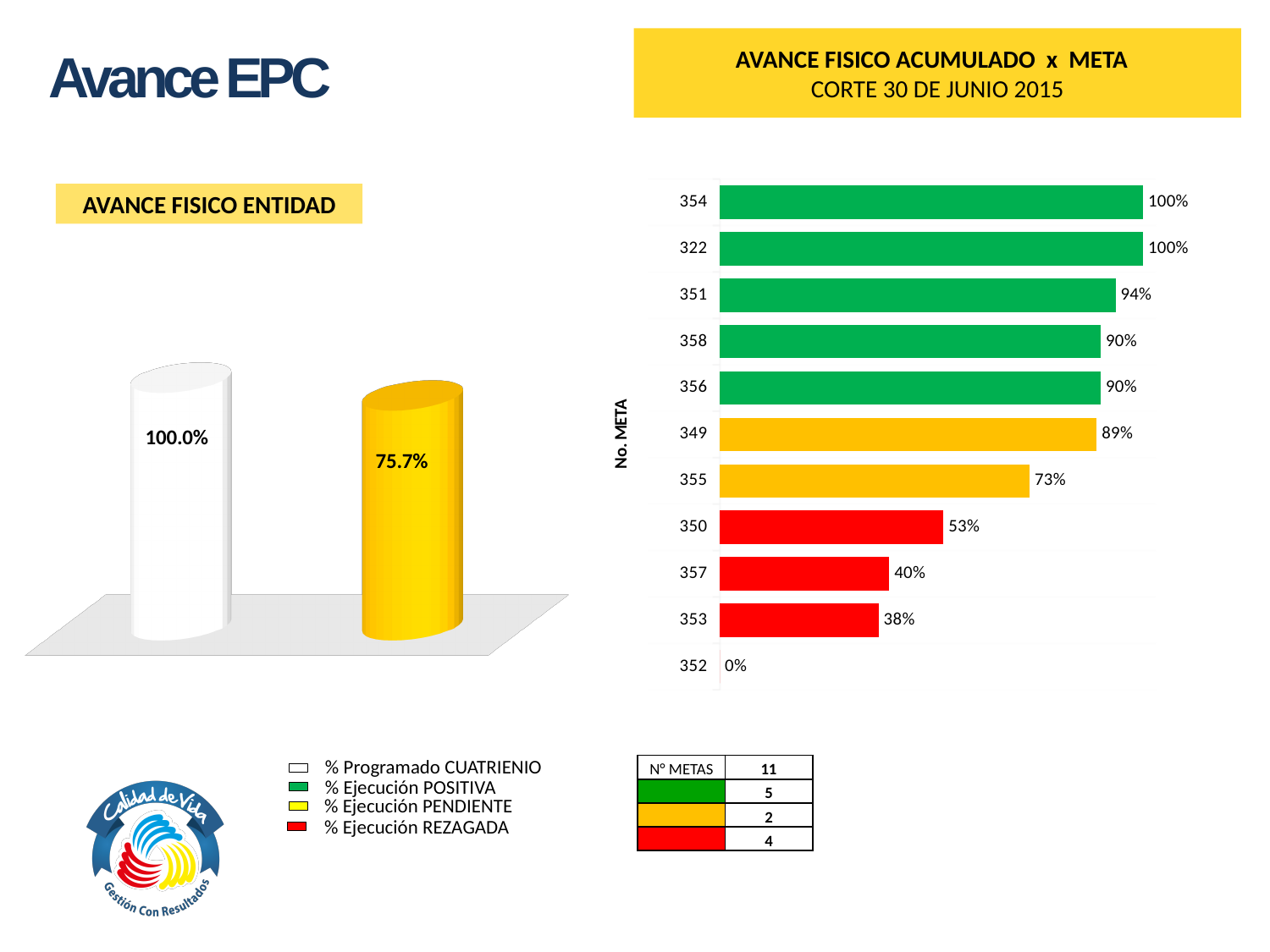
In the AVANCE FISICO ACUMULADO x META chart, what is the value for meta 353? 38% In the AVANCE FISICO ACUMULADO x META chart, which is larger, the value for meta 349 or the value for meta 355? 349 What is the axis label on the vertical axis of the AVANCE FISICO ACUMULADO x META chart? No. META In the AVANCE FISICO ACUMULADO x META chart, what is the difference between the values for meta 350 and meta 357? 13% In the AVANCE FISICO ENTIDAD chart, what is the value of the yellow bar? 75.7% What kind of chart is the AVANCE FISICO ACUMULADO x META chart? Bar chart How many metas are shown in the AVANCE FISICO ACUMULADO x META chart? 11 In the AVANCE FISICO ACUMULADO x META chart, which meta has the lowest value? 352 In the AVANCE FISICO ENTIDAD chart, what is the difference between the two bars? 24.3% In the AVANCE FISICO ENTIDAD chart, which bar is larger, the white one or the yellow one? The white one In the AVANCE FISICO ACUMULADO x META chart, what is the value for meta 355? 73% In the AVANCE FISICO ACUMULADO x META chart, what is the value for meta 351? 94%